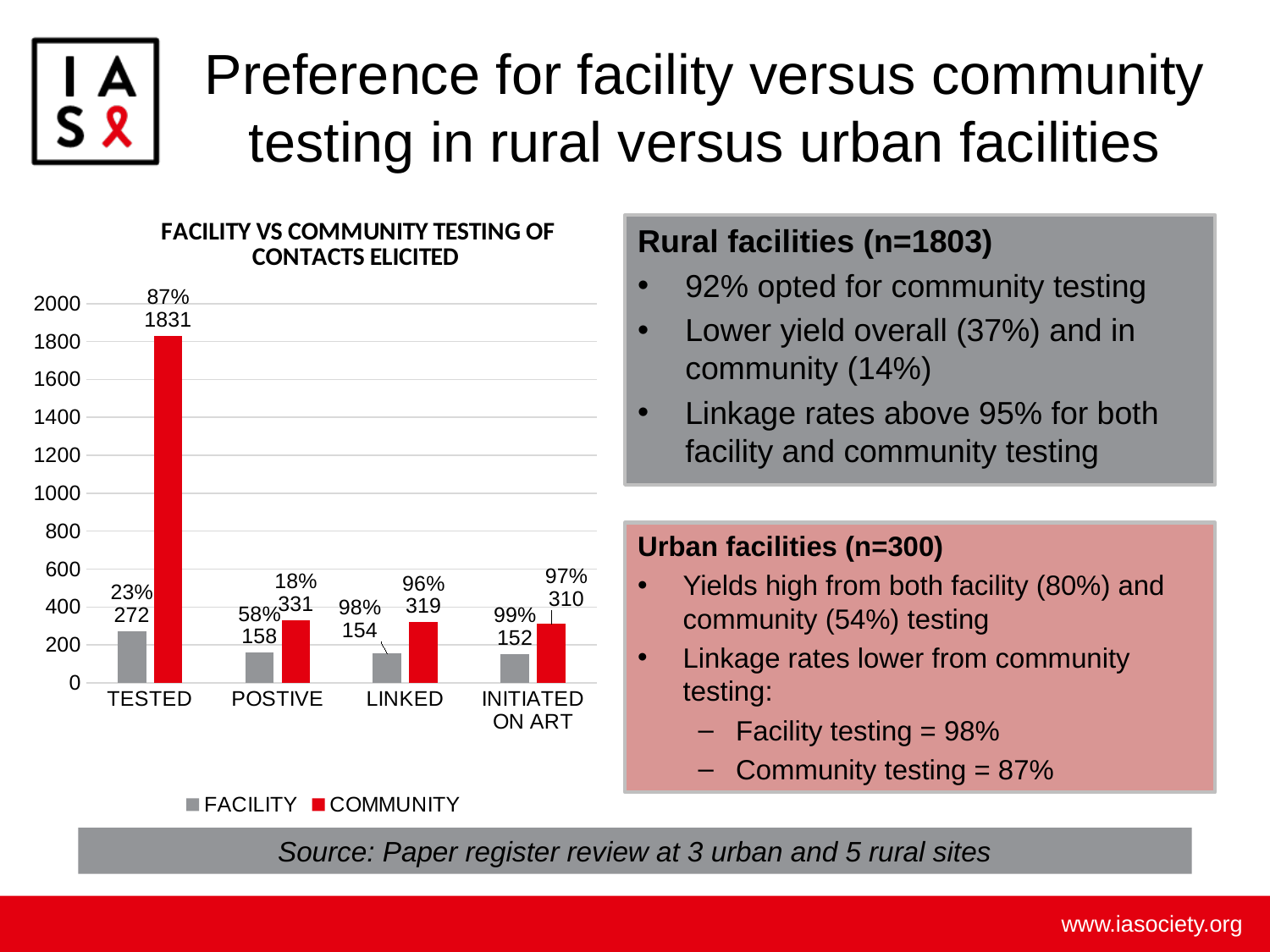
What is the FACILITY value for LINKED? 154 Which category has the highest COMMUNITY value? TESTED How many series does the legend list? 2 What is the COMMUNITY value for INITIATED ON ART? 310 How many categories are shown on the x axis? 4 Which category has the lowest FACILITY value? INITIATED ON ART What is the difference between the COMMUNITY and FACILITY values for TESTED? 1559 Which is larger for LINKED, the FACILITY value or the COMMUNITY value? COMMUNITY What kind of chart is shown on the slide? Bar chart What is the COMMUNITY value for TESTED? 1831 What colour are the COMMUNITY bars? Red What is the FACILITY value for POSTIVE? 158